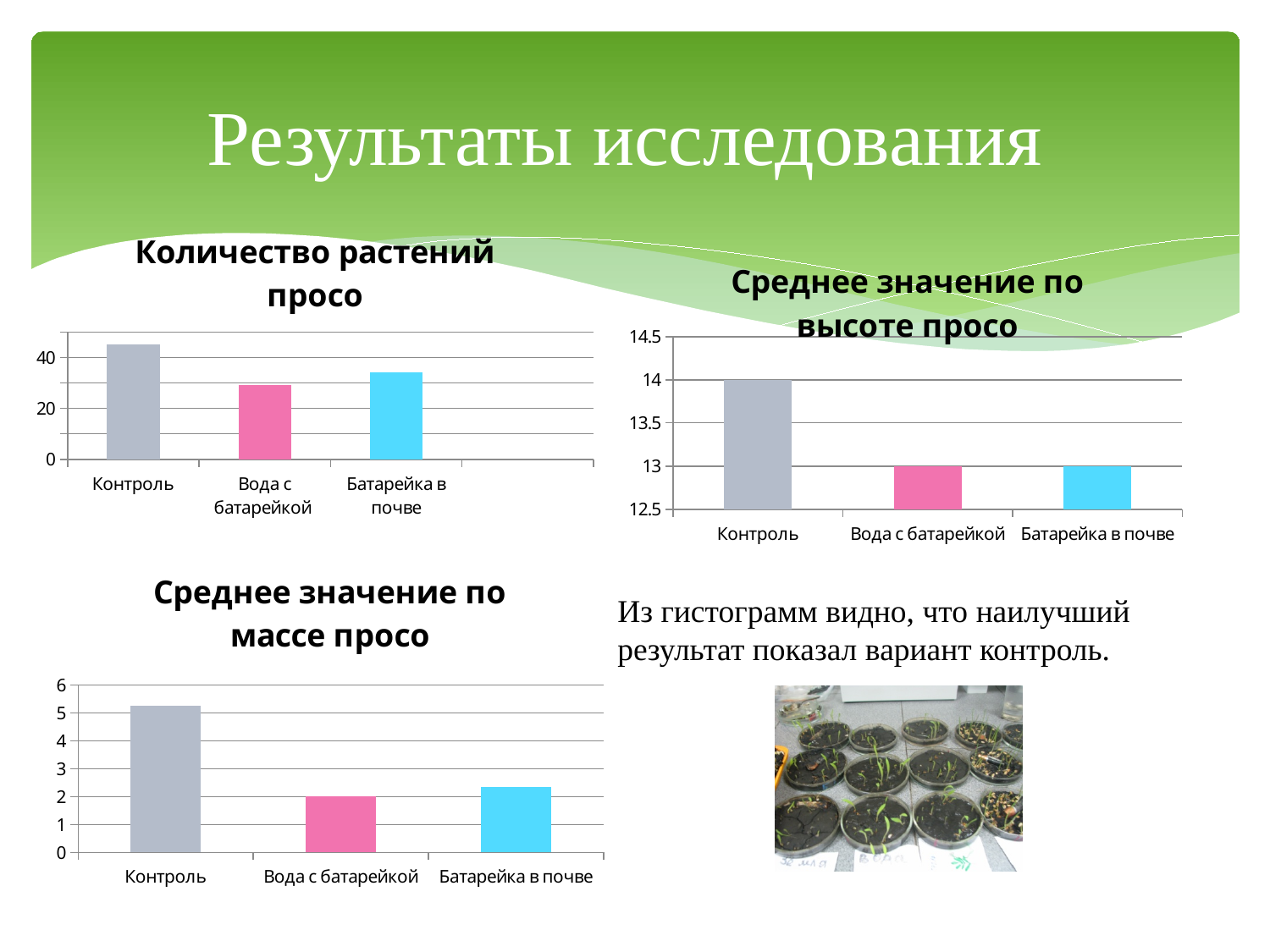
In the "Среднее значение по массе просо" chart, which is larger, Контроль or Батарейка в почве? Контроль In the "Среднее значение по массе просо" chart, which category has the highest value? Контроль What kind of chart is the "Количество растений просо" chart? bar chart In the "Количество растений просо" chart, is the value for Батарейка в почве greater or less than 40? less In the "Количество растений просо" chart, which category has the lowest value? Вода с батарейкой In the "Количество растений просо" chart, which category has the highest value? Контроль In the "Количество растений просо" chart, is the value for Контроль greater or less than 40? greater How many categories are shown in the "Среднее значение по массе просо" chart? 3 In the "Среднее значение по высоте просо" chart, what is the value for Контроль? 14 In the "Среднее значение по массе просо" chart, is the value for Контроль greater or less than 5? greater In the "Среднее значение по высоте просо" chart, what is the difference between Контроль and Батарейка в почве? 1 In the "Среднее значение по высоте просо" chart, what is the value for Вода с батарейкой? 13